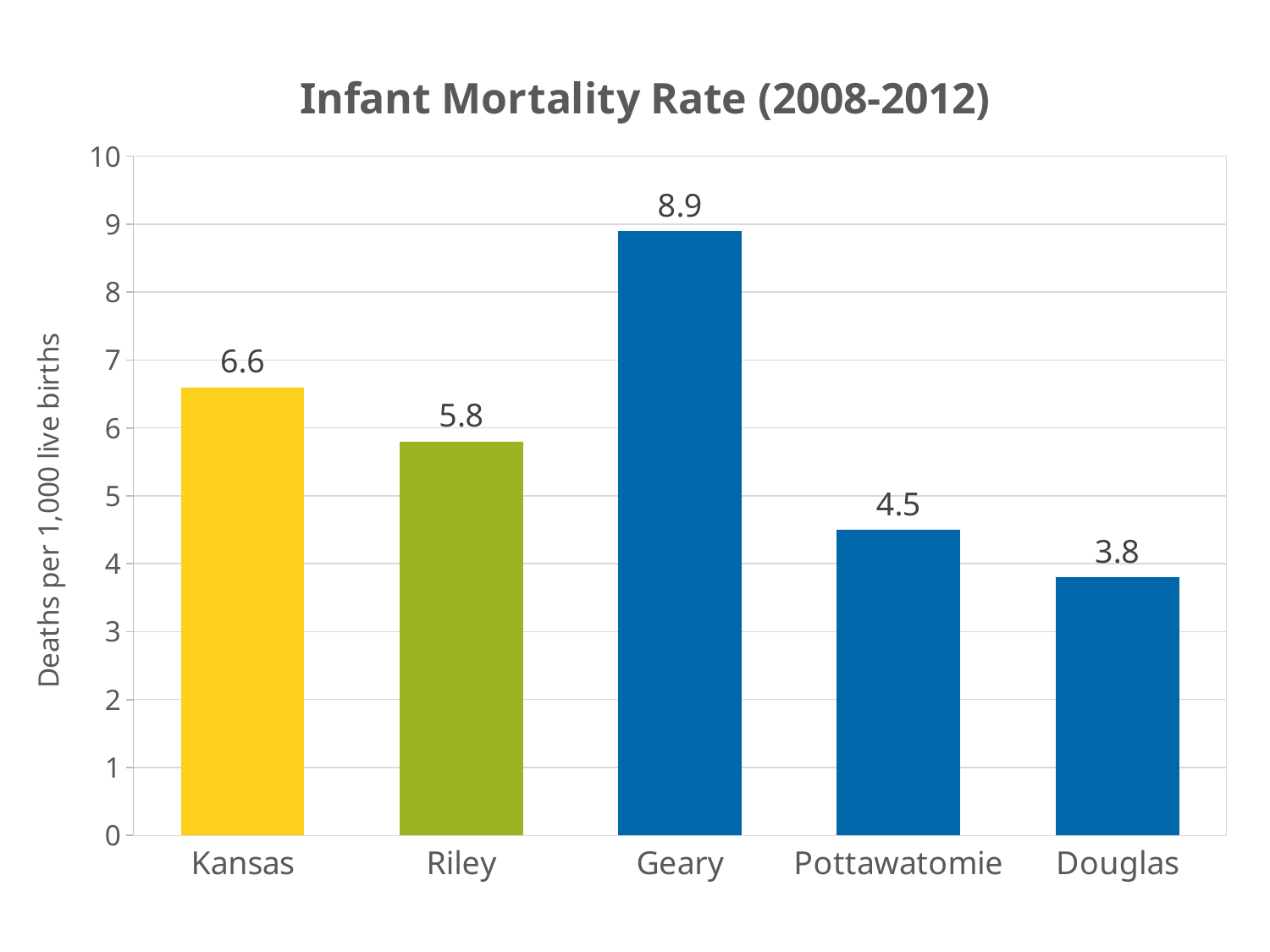
What is the infant mortality rate for Geary? 8.9 Which category has the lowest infant mortality rate? Douglas How many categories are shown on the x axis? 5 What is the infant mortality rate for Kansas? 6.6 Which has a higher infant mortality rate, Riley or Pottawatomie? Riley What is the difference between the infant mortality rates of Kansas and Riley? 0.8 What is the infant mortality rate for Douglas? 3.8 Which category has the highest infant mortality rate? Geary What is the difference between the infant mortality rates of Geary and Douglas? 5.1 What kind of chart is shown on the slide? bar chart Is the value for Pottawatomie greater or less than 5? less What is the title of the chart? Infant Mortality Rate (2008-2012)